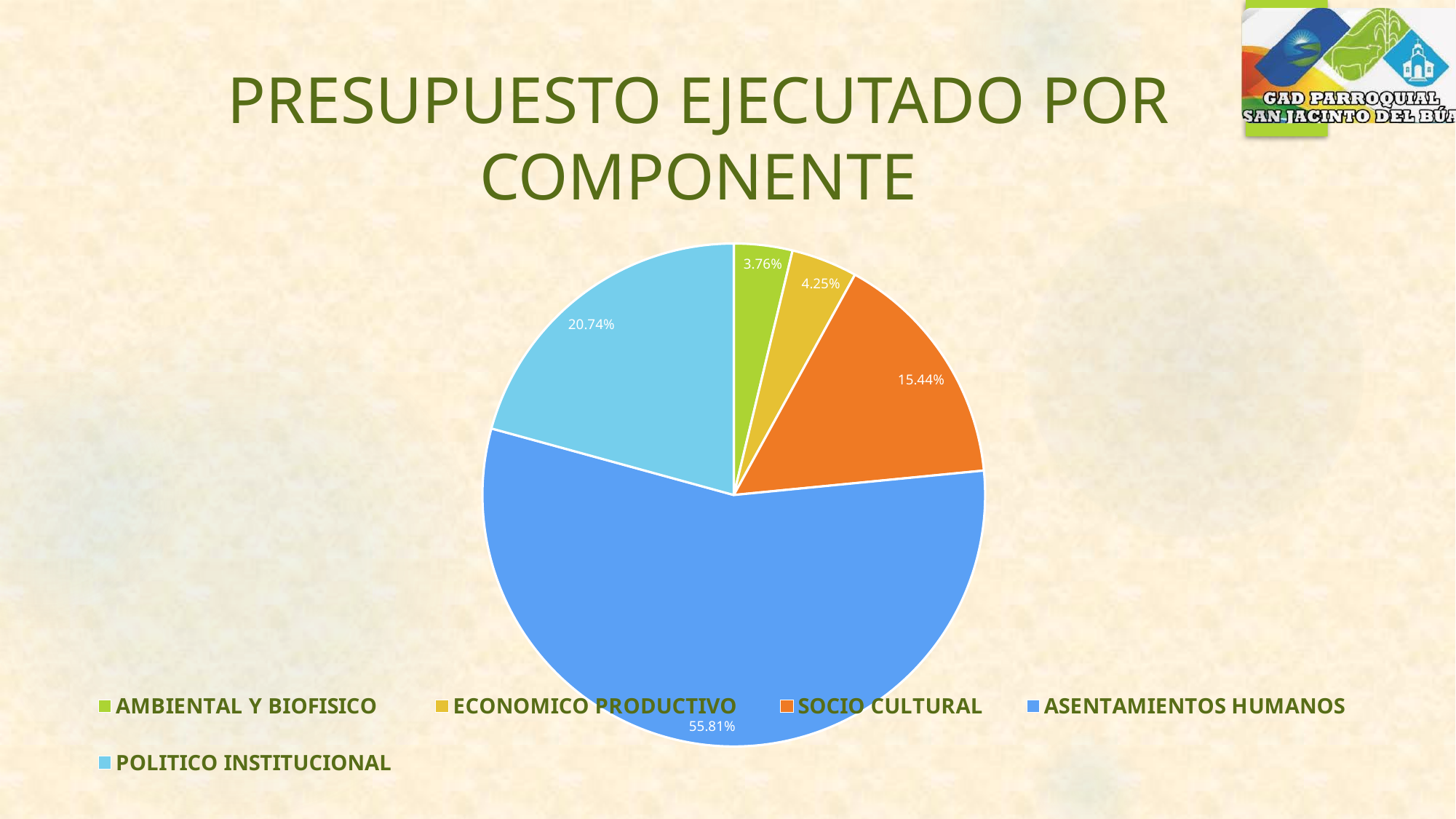
What is the value shown for SOCIO CULTURAL? 15.44% What share of the pie does ASENTAMIENTOS HUMANOS represent? 55.81% What is the value shown for POLITICO INSTITUCIONAL? 20.74% What is the title of the chart? PRESUPUESTO EJECUTADO POR COMPONENTE What is the difference in percentage points between POLITICO INSTITUCIONAL and SOCIO CULTURAL? 5.30% How many slices does the pie chart have? 5 Which component has the smallest share of the pie? AMBIENTAL Y BIOFISICO Which is larger, the share for ECONOMICO PRODUCTIVO or the share for AMBIENTAL Y BIOFISICO? ECONOMICO PRODUCTIVO Which component has the largest share of the pie? ASENTAMIENTOS HUMANOS What type of chart is shown on the slide? Pie chart What is the value shown for ECONOMICO PRODUCTIVO? 4.25% What is the value shown for AMBIENTAL Y BIOFISICO? 3.76%